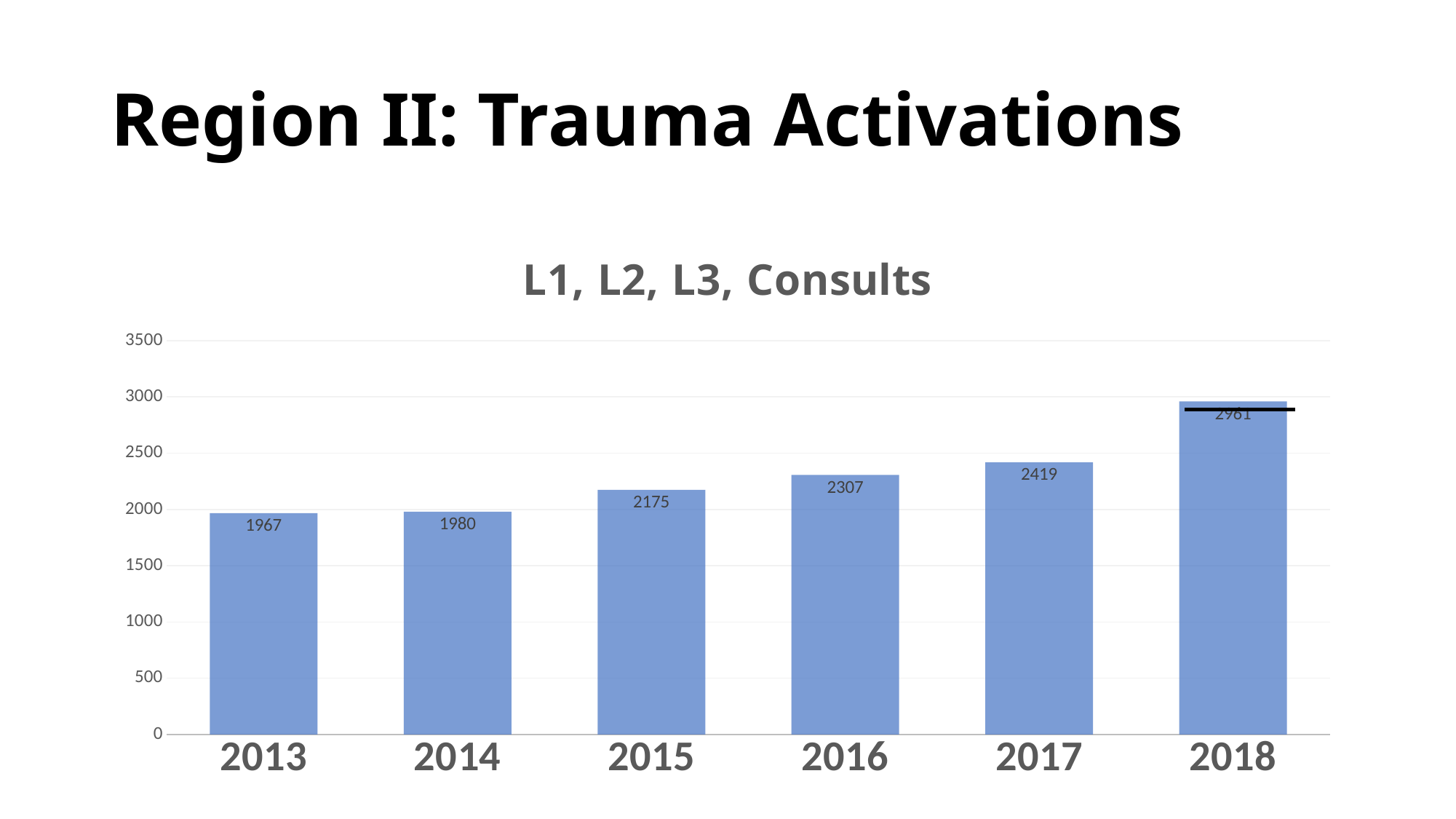
What is the difference between the values for 2016 and 2014? 327 Which year has the highest value? 2018 What is the title of the chart? L1, L2, L3, Consults What kind of chart is shown? bar chart Which is larger, the value for 2015 or the value for 2017? 2017 What is the value for 2013? 1967 How many years are shown on the x axis? 6 Is the value for 2018 greater or less than 2500? greater What is the value for 2015? 2175 What is the value for 2017? 2419 Do the values rise or fall from 2013 to 2018? rise Which year has the lowest value? 2013